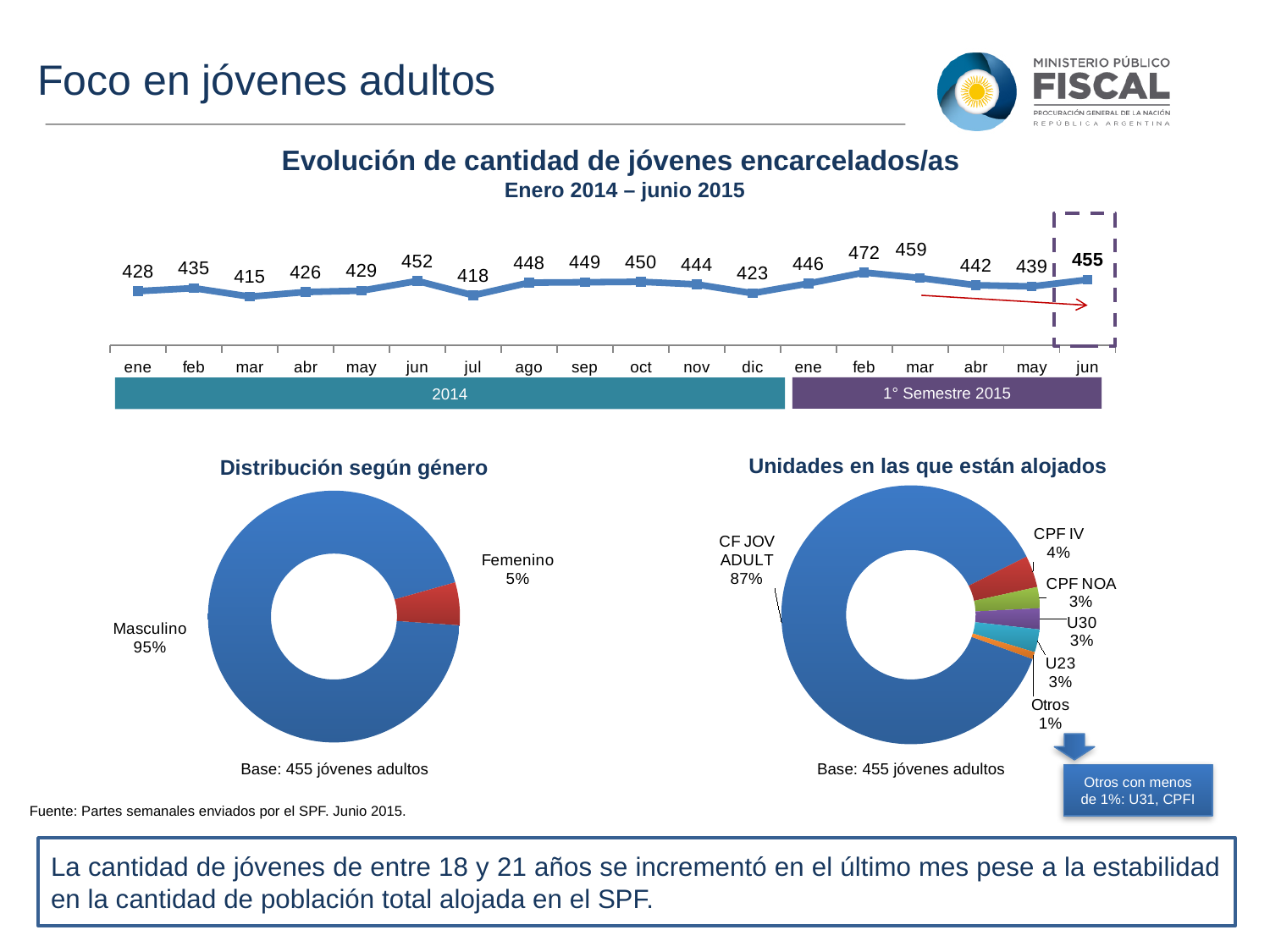
In the chart 'Distribución según género', which category has the largest share? Masculino In the chart 'Evolución de cantidad de jóvenes encarcelados/as', which month has the highest value? feb 2015 In the chart 'Evolución de cantidad de jóvenes encarcelados/as', what is the value for jun 2015? 455 How many data points are plotted in the chart 'Evolución de cantidad de jóvenes encarcelados/as'? 18 In the chart 'Evolución de cantidad de jóvenes encarcelados/as', what is the difference between the values for feb 2015 and mar 2015? 13 In the chart 'Evolución de cantidad de jóvenes encarcelados/as', what is the value for mar 2014? 415 In the chart 'Unidades en las que están alojados', what share is CPF IV? 4% What kind of chart is 'Evolución de cantidad de jóvenes encarcelados/as'? line chart How many slices does the chart 'Unidades en las que están alojados' have? 6 In the chart 'Evolución de cantidad de jóvenes encarcelados/as', which month has the lowest value? mar 2014 In the chart 'Distribución según género', what share is Femenino? 5% In the chart 'Evolución de cantidad de jóvenes encarcelados/as', which is larger, the value for jun 2014 or the value for jul 2014? jun 2014